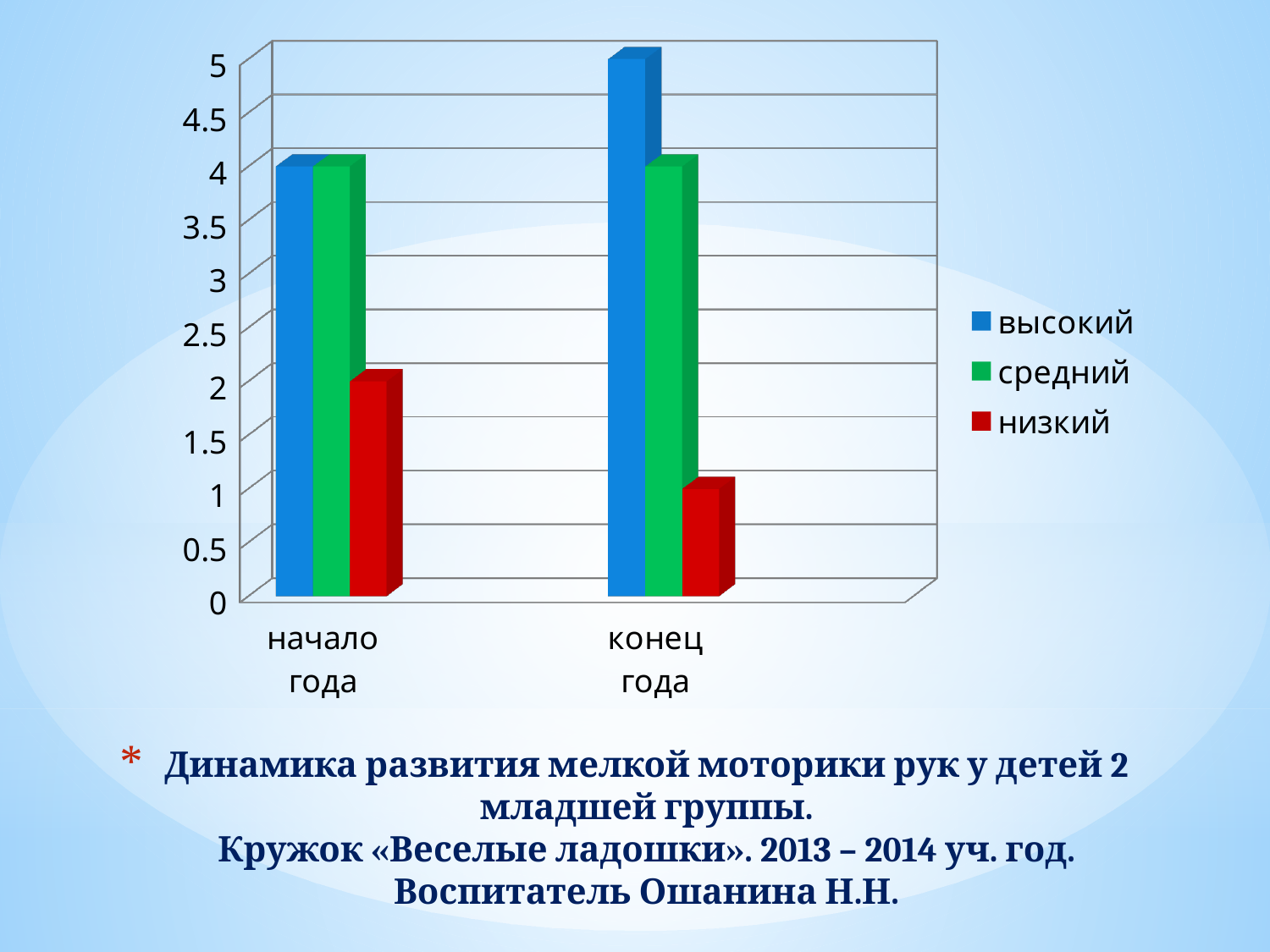
What is the value for низкий at конец года? 1 Which series has the lowest value at конец года? низкий Is the value for высокий at конец года larger or smaller than the value for высокий at начало года? larger Which series has the highest value at конец года? высокий How many categories are shown on the x axis? 2 What is the difference between the низкий values at начало года and конец года? 1 What is the value for низкий at начало года? 2 What kind of chart is shown on the slide? bar chart How many series does the legend list? 3 Which colour represents the series средний in the legend? green What is the value for средний at начало года? 4 What is the value for высокий at конец года? 5